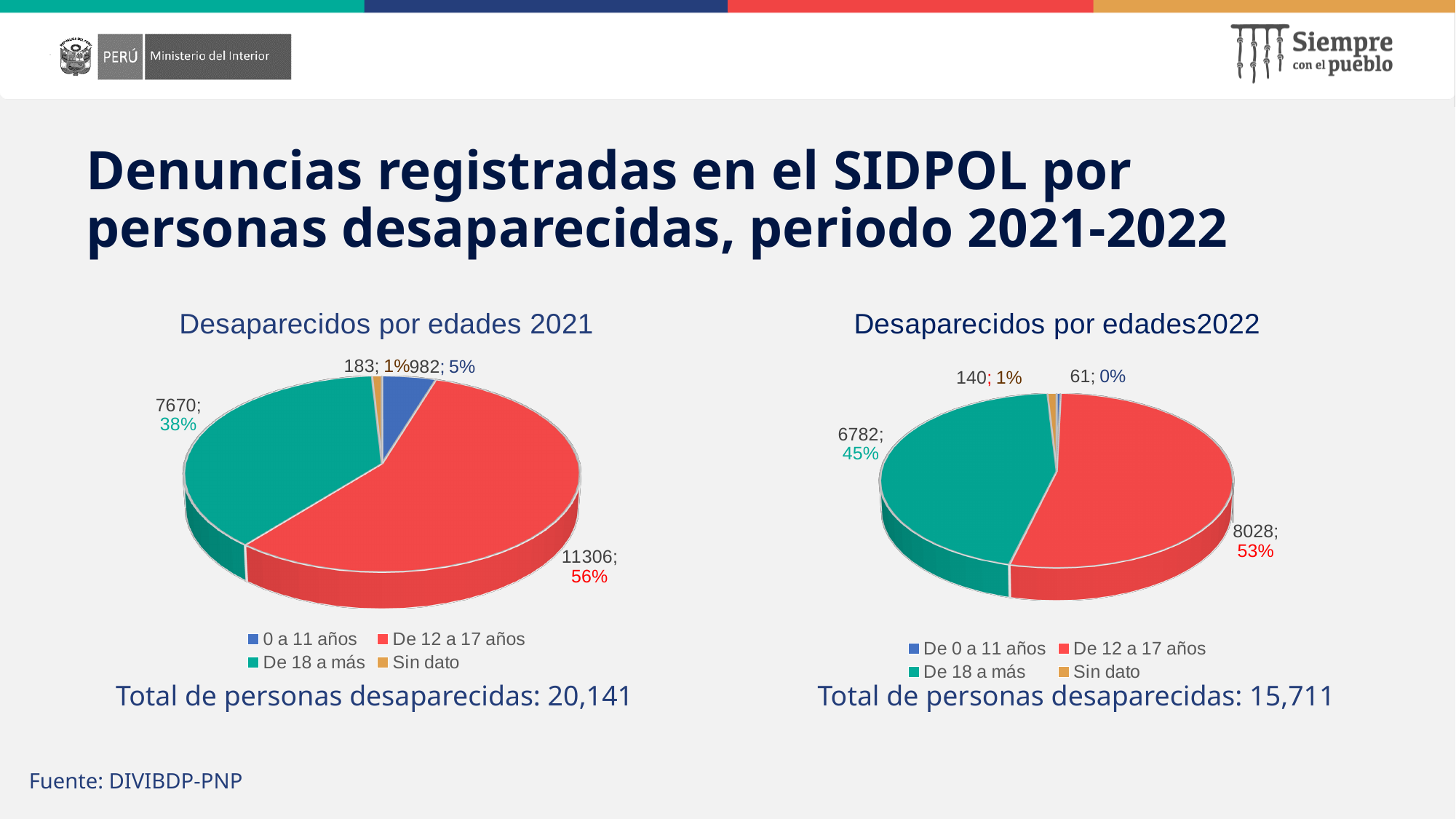
How many categories does the chart 'Desaparecidos por edades2022' show? 4 In the chart 'Desaparecidos por edades2022', what share of the pie does 'De 12 a 17 años' represent? 53% In the chart 'Desaparecidos por edades 2021', what share of the pie does 'De 18 a más' represent? 38% In the chart 'Desaparecidos por edades2022', which category has the lowest value? De 0 a 11 años In the chart 'Desaparecidos por edades2022', which is larger: 'Sin dato' or 'De 0 a 11 años'? Sin dato In the chart 'Desaparecidos por edades 2021', what is the difference between 'De 12 a 17 años' and 'De 18 a más'? 3636 In the chart 'Desaparecidos por edades 2021', which colour represents 'De 18 a más'? Green In the chart 'Desaparecidos por edades 2021', which category has the highest value? De 12 a 17 años What kind of chart is 'Desaparecidos por edades 2021'? Pie chart In the chart 'Desaparecidos por edades 2021', what is the value for 'Sin dato'? 183 In the chart 'Desaparecidos por edades 2021', what is the value for 'De 12 a 17 años'? 11306 In the chart 'Desaparecidos por edades2022', what is the value for 'De 18 a más'? 6782